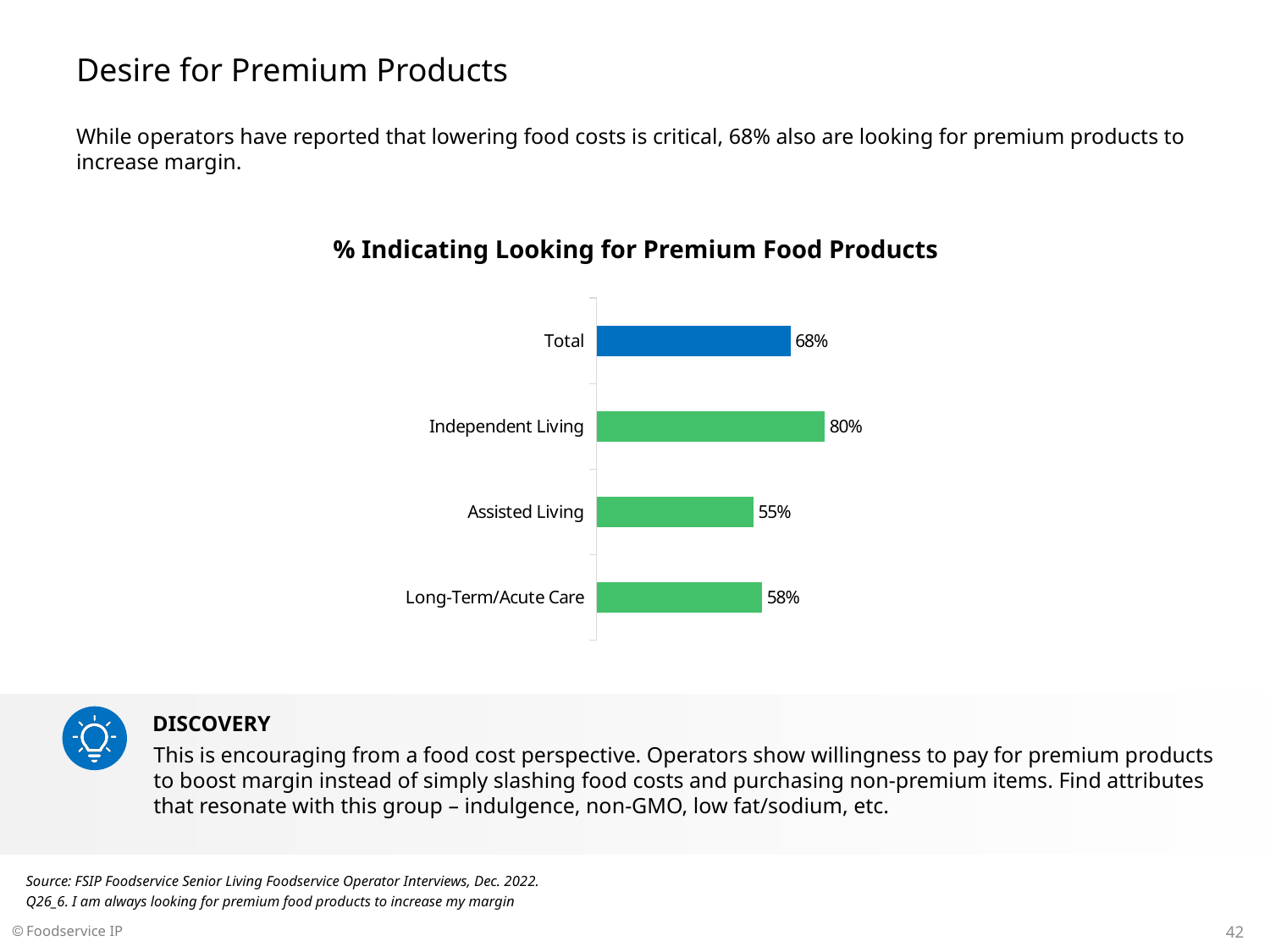
What is the difference between the values for Independent Living and Assisted Living? 25% What kind of chart is shown on the slide? Bar chart What is the value for Assisted Living? 55% How many categories are shown in the chart? 4 Which category has the highest value? Independent Living What is the value for Total? 68% Which is larger, the value for Long-Term/Acute Care or the value for Assisted Living? Long-Term/Acute Care What is the title of the chart? % Indicating Looking for Premium Food Products Which category has the lowest value? Assisted Living What is the difference between the values for Total and Long-Term/Acute Care? 10% What is the value for Long-Term/Acute Care? 58% What is the value for Independent Living? 80%